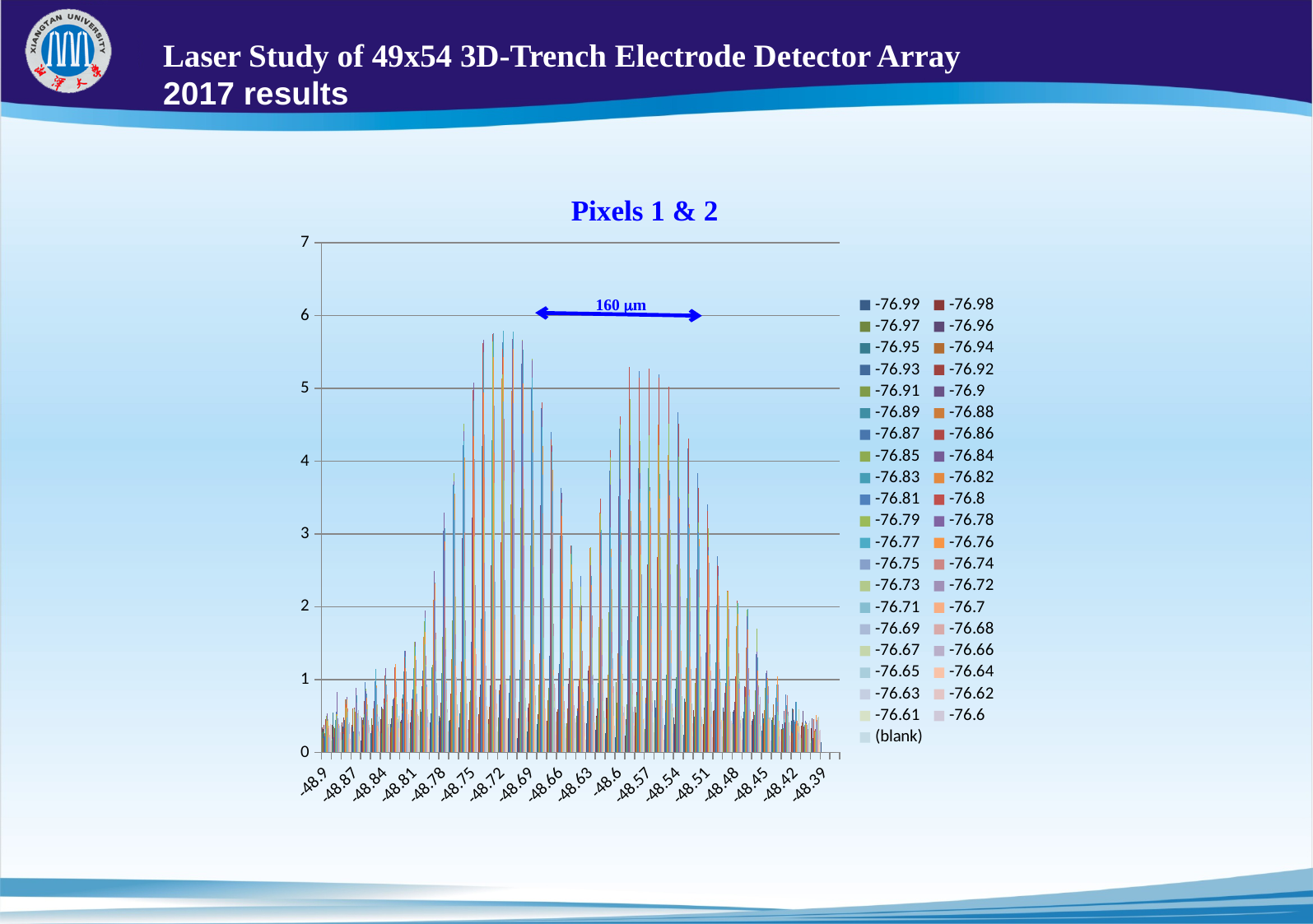
How many labelled categories are shown on the chart's x axis? 18 What distance is labelled by the blue double-headed arrow on the chart? 160 μm Are the bars at the x-axis category -48.9 greater or less than 1? less Are the bars at the x-axis category -48.39 greater or less than 1? less What is the title of the chart? Pixels 1 & 2 Is the tallest bar on the chart greater or less than 6? less Which x-axis region has the taller peak: around -48.72 or around -48.57? around -48.72 What kind of chart is shown on the slide? bar chart How many entries does the chart's legend list? 41 What is the first x-axis label on the left of the chart? -48.9 What is the highest value shown on the chart's vertical axis? 7